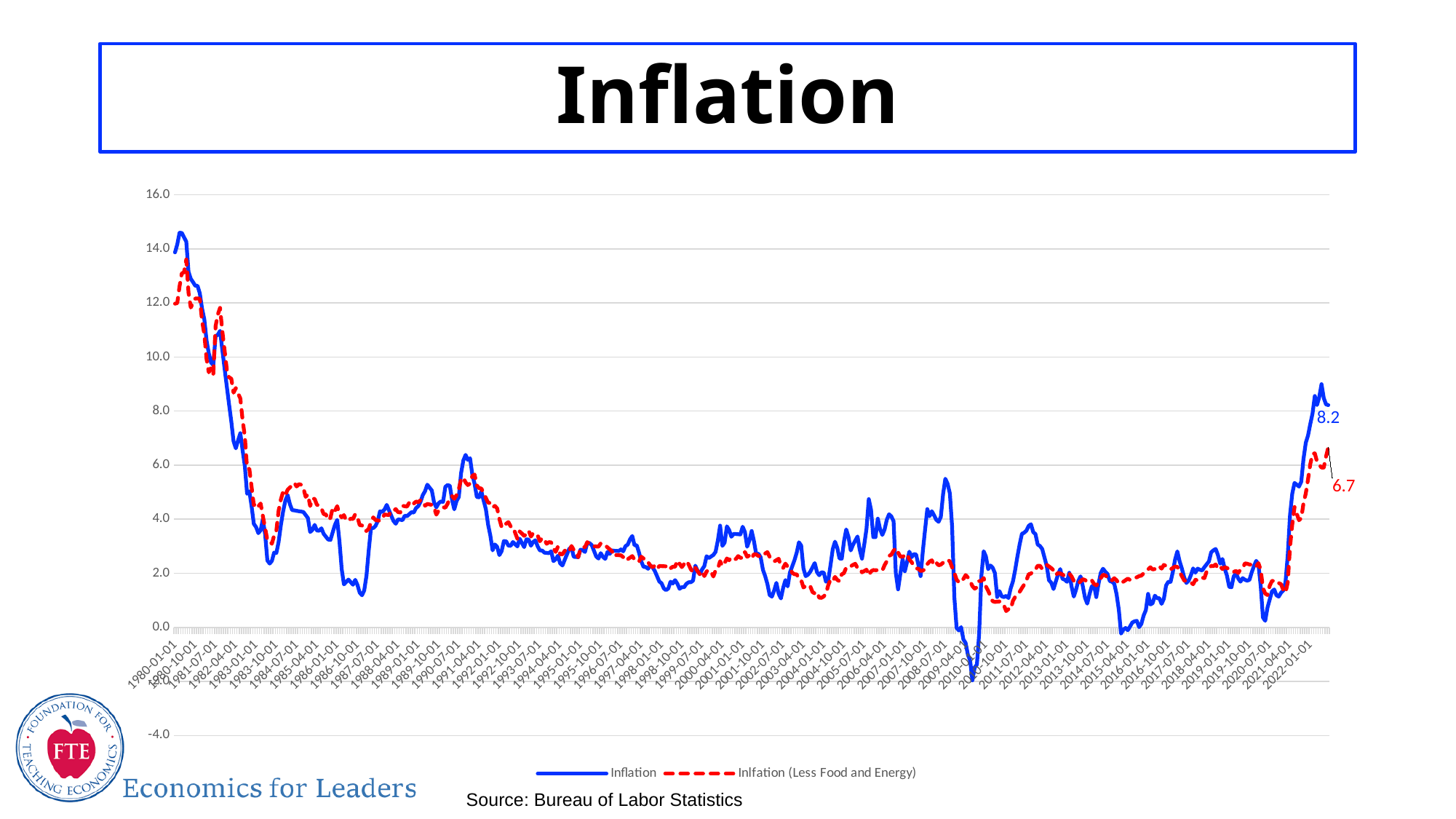
At the end of the chart, which series has the higher labelled value, Inflation or Inflation (Less Food and Energy)? Inflation Is the peak value of the Inflation series around 1980 greater or less than 14.0? greater What source is cited for the chart data? Bureau of Labor Statistics What is the labelled value at the end of the Inflation series? 8.2 What is the difference between the labelled end values of the Inflation series (8.2) and the Inflation (Less Food and Energy) series (6.7)? 1.5 What kind of chart is shown on the slide? line chart How many series does the legend list? 2 Does the Inflation series rise or fall between 1980-01-01 and 1983-01-01? fall What is the labelled value at the end of the Inflation (Less Food and Energy) series? 6.7 Is the lowest value of the Inflation series around 2009 greater or less than 0.0? less Which series is drawn as a red dashed line? Inflation (Less Food and Energy) Which series reaches the highest value anywhere on the chart? Inflation